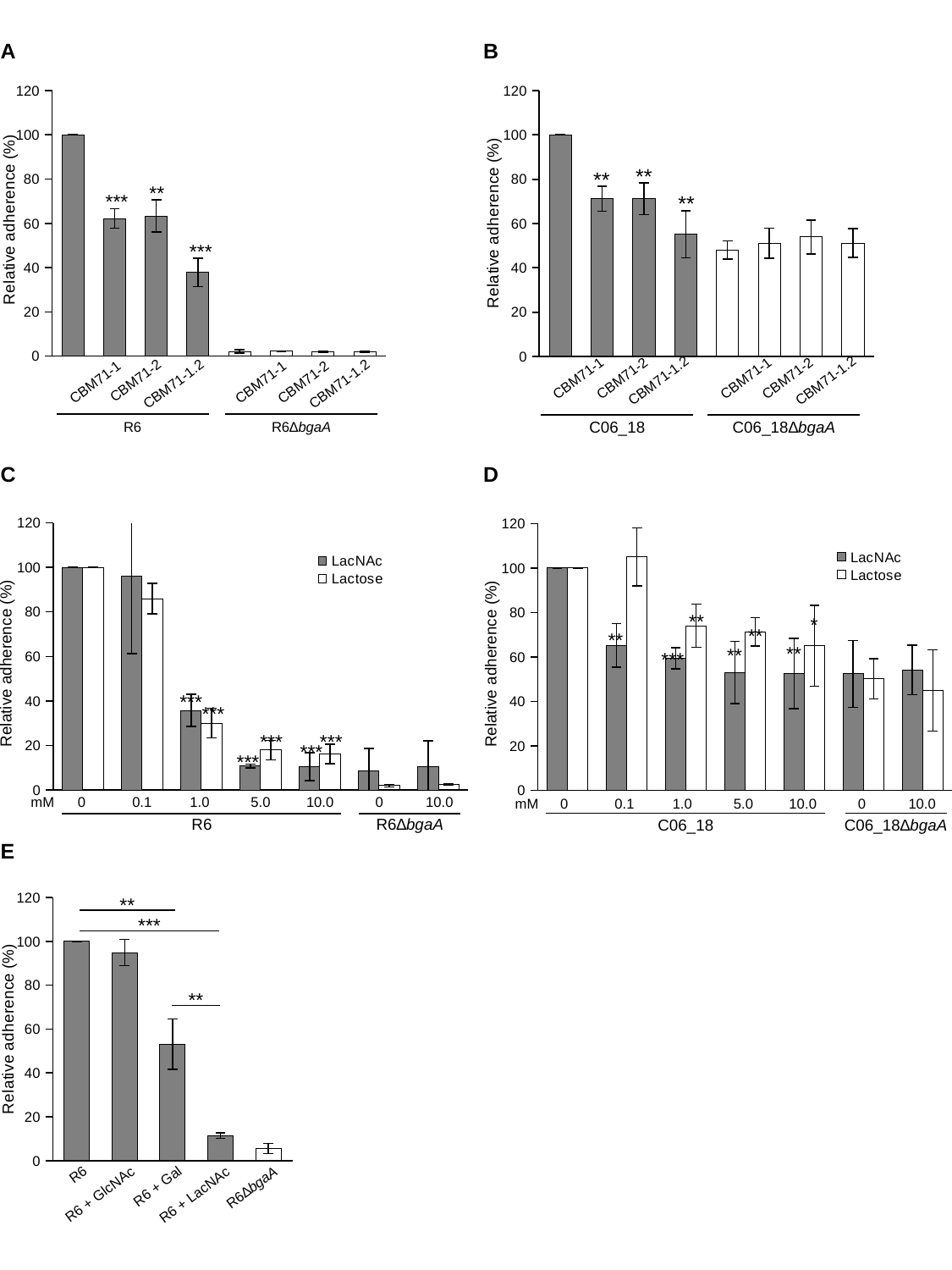
In panel E, is the value for R6 + LacNAc greater or less than 20? less In panel E, what is the relative adherence (%) for R6? 100 In panel A, is the value for CBM71-2 in the R6ΔbgaA group greater or less than 20? less In panel E, which is larger, the value for R6 + GlcNAc or the value for R6 + Gal? R6 + GlcNAc In panel E, how many bars are plotted? 5 In panel E, which category has the highest relative adherence? R6 In panel A, is the value for CBM71-1 in the R6 group greater or less than 80? less In panel D, what kind of chart is shown? bar chart In panel D, what are the two series named in the legend? LacNAc and Lactose In panel C, how many series does the legend list? 2